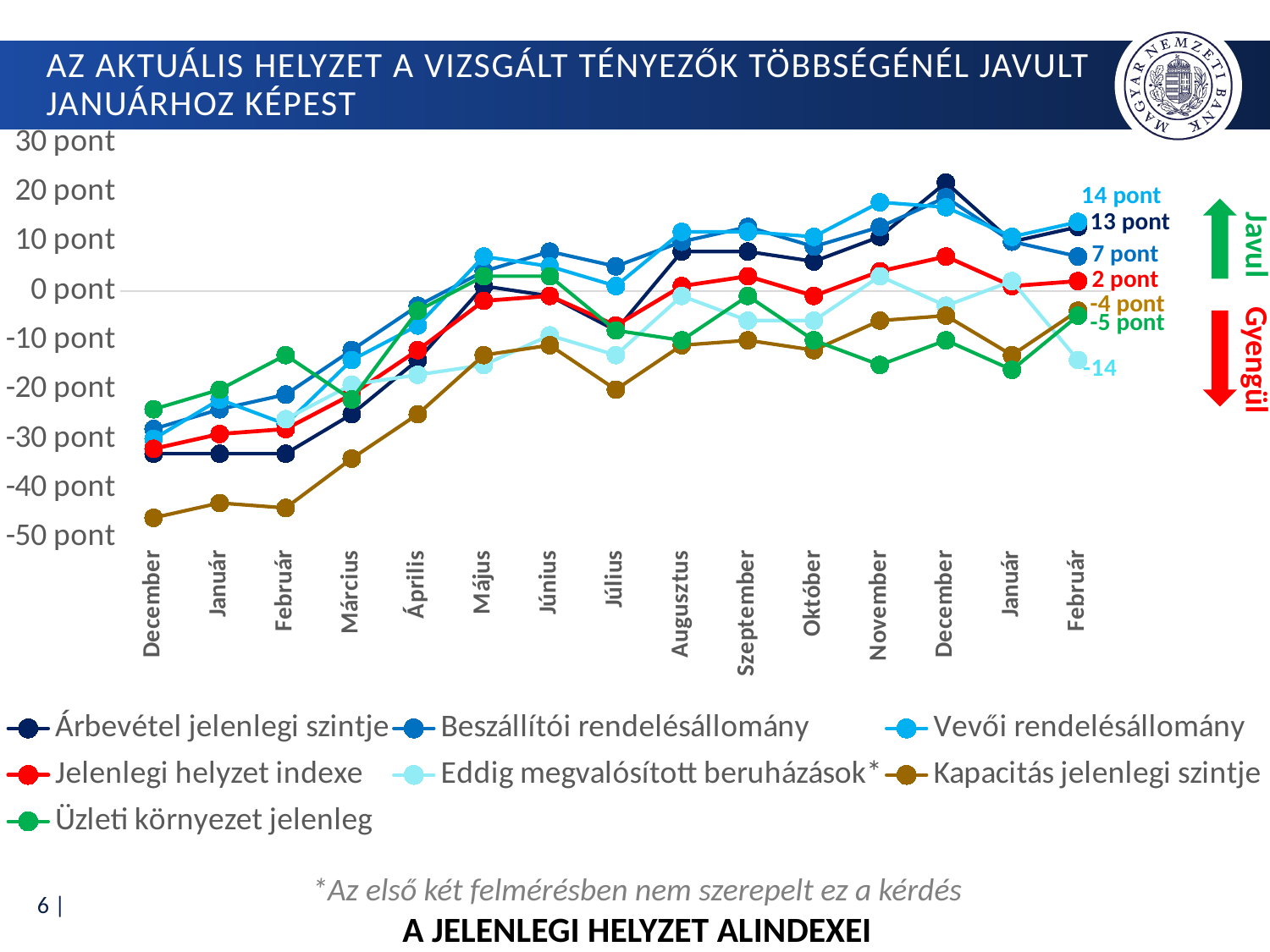
What is the value of Árbevétel jelenlegi szintje at the final Február point? 13 pont What is the value of Jelenlegi helyzet indexe at the final Február point? 2 pont What is the value of Vevői rendelésállomány at the final Február point? 14 pont Is the value of Kapacitás jelenlegi szintje at the first December point greater or less than -40 pont? less What kind of chart is shown on the slide? line chart At the final Február point, what is the difference between Vevői rendelésállomány and Jelenlegi helyzet indexe? 12 pont Which series has the highest value at the final Február point? Vevői rendelésállomány Which series has the lowest value at the final Február point? Eddig megvalósított beruházások What is the value of Eddig megvalósított beruházások at the final Február point? -14 At the final Február point, which is larger: Kapacitás jelenlegi szintje or Üzleti környezet jelenleg? Kapacitás jelenlegi szintje How many series does the legend list? 7 Does the Kapacitás jelenlegi szintje series rise or fall overall from the first December to the final Február? rise